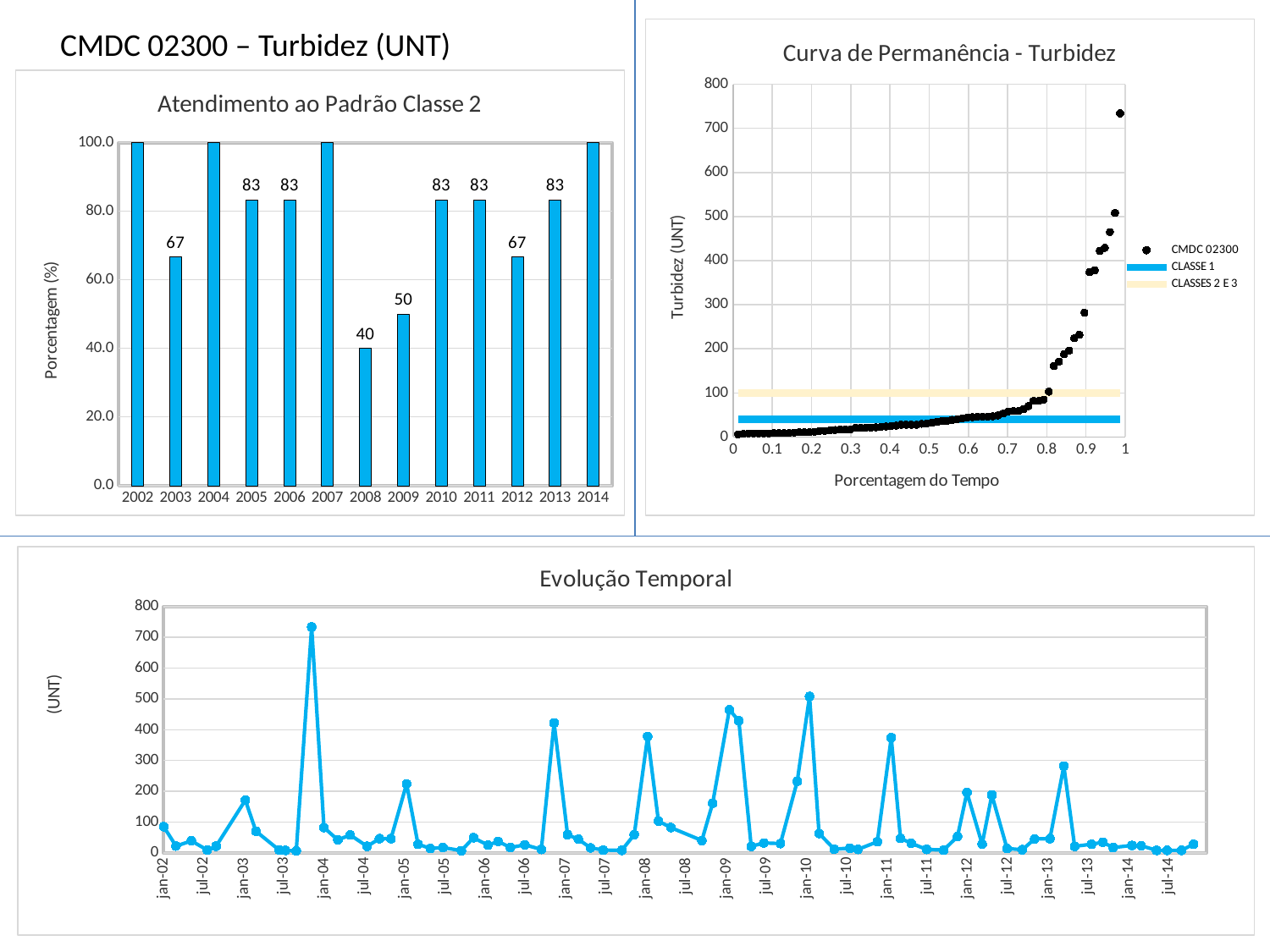
In the 'Atendimento ao Padrão Classe 2' chart, which is larger, the value for 2009 or the value for 2012? 2012 In the 'Atendimento ao Padrão Classe 2' chart, what is the value for 2008? 40 In the 'Curva de Permanência - Turbidez' chart, is the CLASSE 1 line greater or less than 100? less What is the x-axis title of the 'Curva de Permanência - Turbidez' chart? Porcentagem do Tempo What kind of chart is 'Atendimento ao Padrão Classe 2'? bar chart In the 'Atendimento ao Padrão Classe 2' chart, is the value for 2002 greater or less than 80.0? greater How many entries does the legend of the 'Curva de Permanência - Turbidez' chart list? 3 In the 'Atendimento ao Padrão Classe 2' chart, what is the difference between the values for 2005 and 2008? 43 In the 'Atendimento ao Padrão Classe 2' chart, which year has the lowest value? 2008 In the 'Atendimento ao Padrão Classe 2' chart, what is the value for 2012? 67 How many years are shown on the x axis of the 'Atendimento ao Padrão Classe 2' chart? 13 In the 'Evolução Temporal' chart, is the highest point greater or less than 700? greater